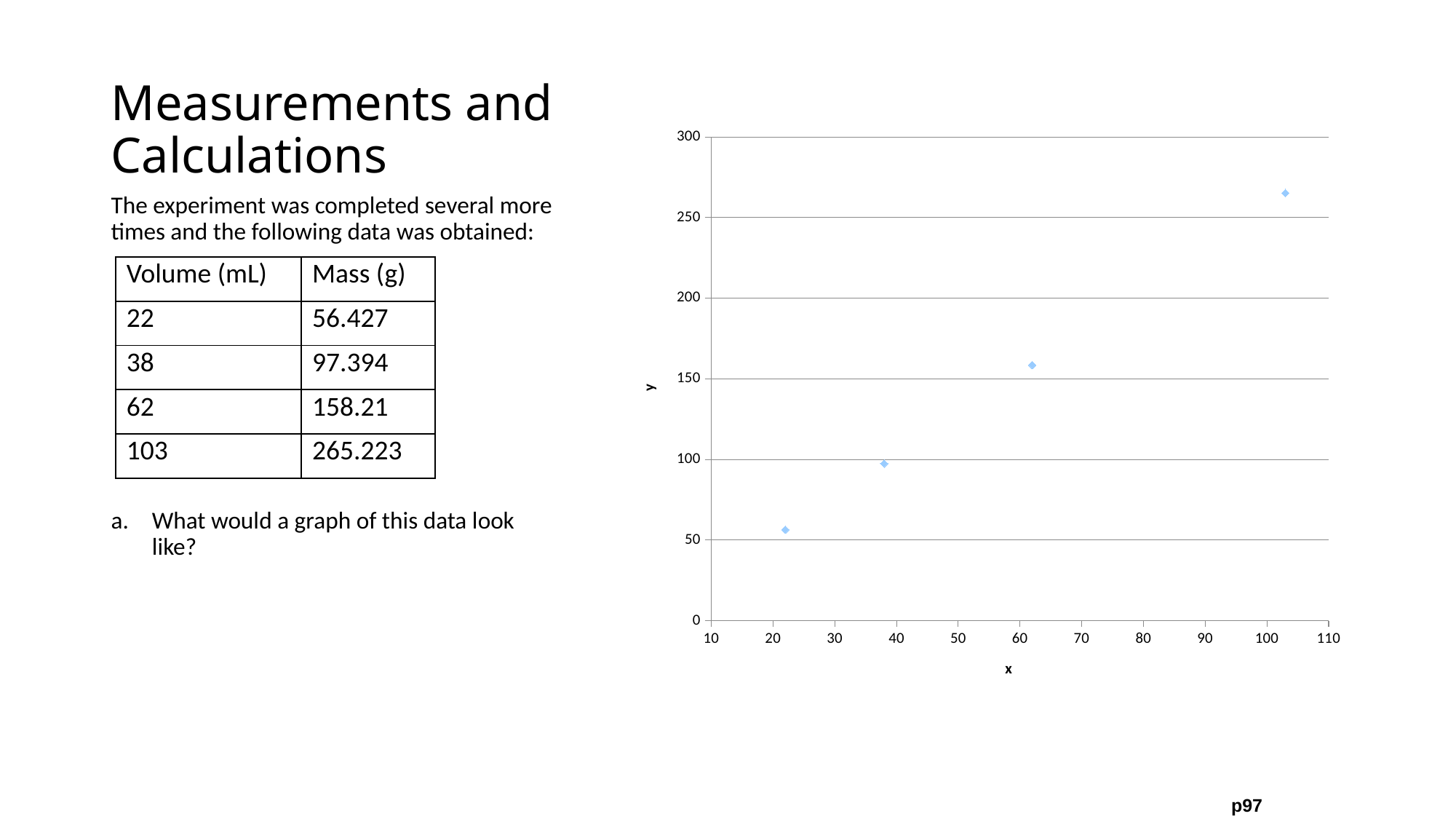
Is the y value of the point at x = 62 greater or less than 150? greater How many data points are plotted on the chart? 4 What is the highest tick value shown on the vertical axis? 300 Is the y value of the point at x = 103 greater or less than 250? greater Which plotted point has the highest y value, the one at x = 62 or the one at x = 103? x = 103 What is the label on the horizontal axis of the chart? x At which x value does the point with the highest y value lie? 103 What kind of chart is shown on the slide? scatter chart Is the y value of the point at x = 22 greater or less than 50? greater At which x value does the point with the lowest y value lie? 22 Do the y values rise or fall as x increases along the chart? rise